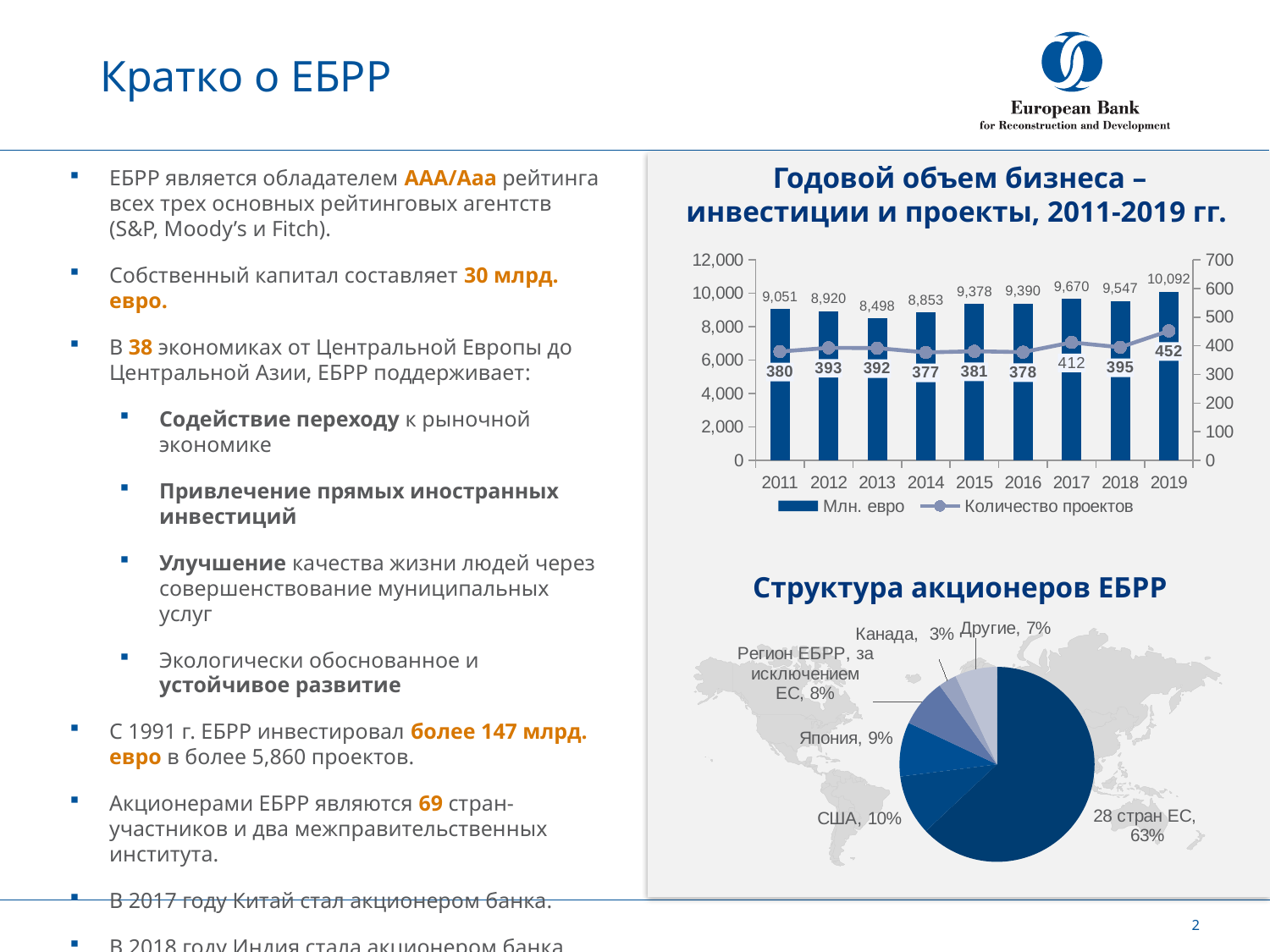
In the chart 'Структура акционеров ЕБРР', what share do the '28 стран ЕС' hold? 63% In the chart 'Годовой объем бизнеса – инвестиции и проекты, 2011-2019 гг.', what is the value of 'Млн. евро' for 2019? 10,092 In the chart 'Годовой объем бизнеса – инвестиции и проекты, 2011-2019 гг.', which year has the larger 'Млн. евро' value, 2012 or 2014? 2012 What type of chart is 'Структура акционеров ЕБРР'? Pie chart In the chart 'Годовой объем бизнеса – инвестиции и проекты, 2011-2019 гг.', what is the 'Количество проектов' value for 2017? 412 In the chart 'Годовой объем бизнеса – инвестиции и проекты, 2011-2019 гг.', which year has the highest 'Количество проектов' value? 2019 In the chart 'Годовой объем бизнеса – инвестиции и проекты, 2011-2019 гг.', how many series does the legend list? 2 In the chart 'Годовой объем бизнеса – инвестиции и проекты, 2011-2019 гг.', what is the difference in 'Млн. евро' between 2019 and 2018? 545 In the chart 'Годовой объем бизнеса – инвестиции и проекты, 2011-2019 гг.', how many years are shown on the x axis? 9 In the chart 'Годовой объем бизнеса – инвестиции и проекты, 2011-2019 гг.', which year has the lowest 'Млн. евро' value? 2013 In the chart 'Структура акционеров ЕБРР', what is the difference between the shares of 'США' and 'Япония'? 1% In the chart 'Структура акционеров ЕБРР', which category has the smallest share? Канада